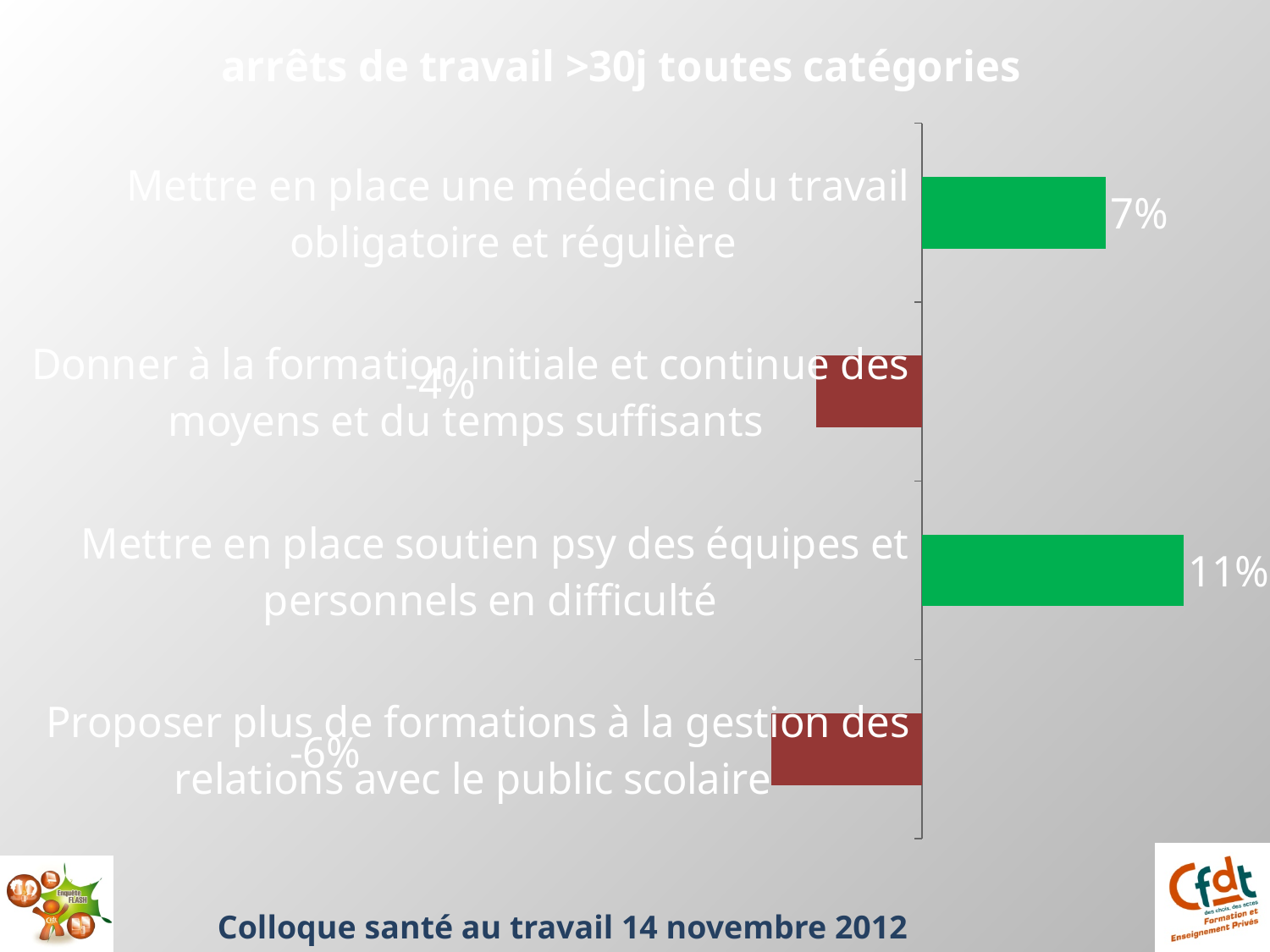
What is the value for "Mettre en place soutien psy des équipes et personnels en difficulté"? 11% Which category has the lowest value? Proposer plus de formations à la gestion des relations avec le public scolaire Which category has the highest value? Mettre en place soutien psy des équipes et personnels en difficulté What is the difference between the value for "Mettre en place soutien psy des équipes et personnels en difficulté" and the value for "Mettre en place une médecine du travail obligatoire et régulière"? 4% Which is larger: the value for "Mettre en place une médecine du travail obligatoire et régulière" or the value for "Donner à la formation initiale et continue des moyens et du temps suffisants"? Mettre en place une médecine du travail obligatoire et régulière What is the value for "Proposer plus de formations à la gestion des relations avec le public scolaire"? -6% What is the value for "Donner à la formation initiale et continue des moyens et du temps suffisants"? -4% What kind of chart is shown on the slide? Bar chart What is the value for "Mettre en place une médecine du travail obligatoire et régulière"? 7% What is the title of the chart? arrêts de travail >30j toutes catégories How many categories are shown in the chart? 4 How many categories have a negative value? 2